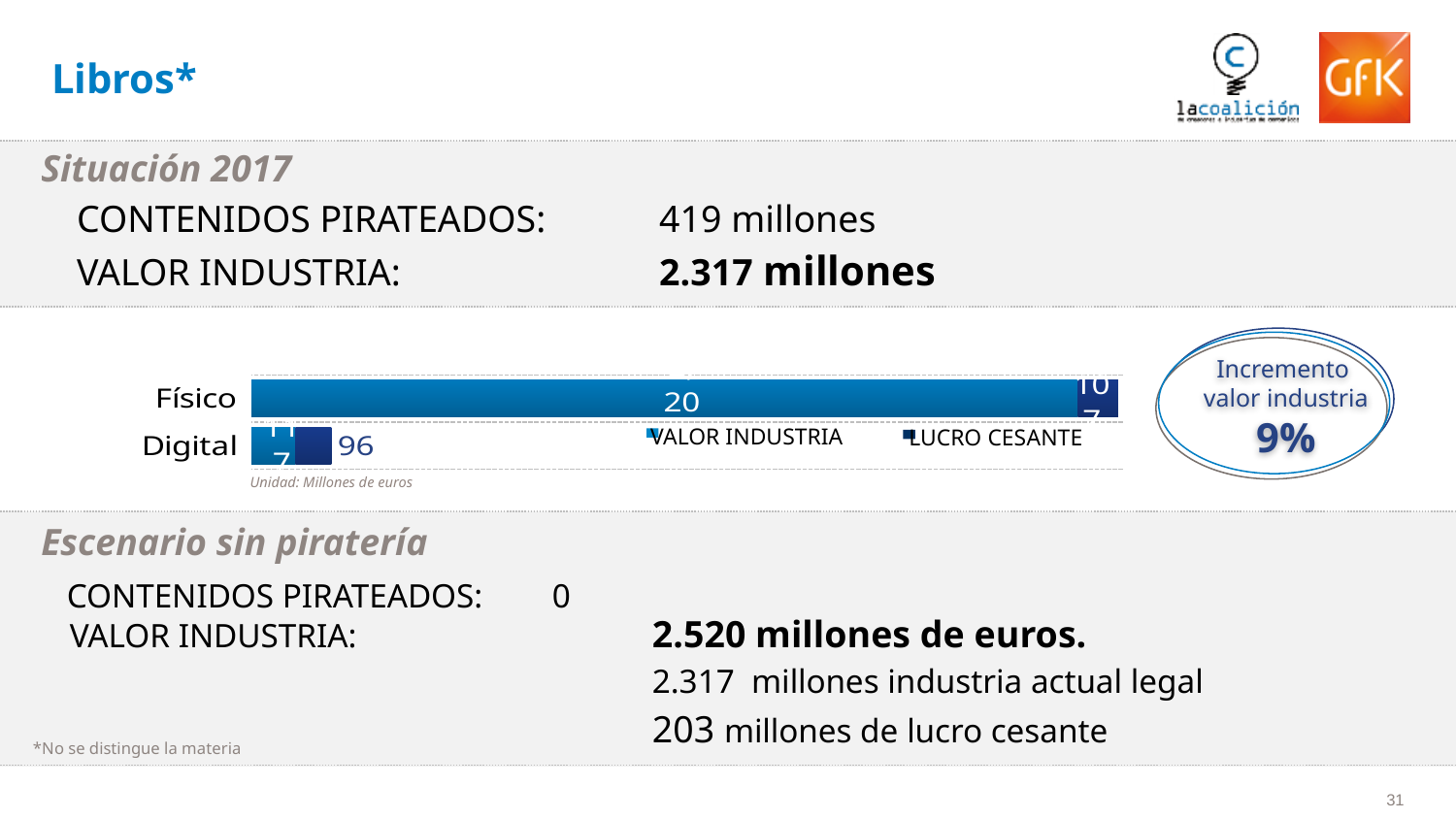
How many series does the legend of the bar chart list? 2 In what unit are the values of the bar chart expressed, according to the note under the chart? Millones de euros Which category has the largest total bar in the chart? Físico What are the two categories shown on the bar chart? Físico and Digital How many categories does the bar chart show? 2 Which category has the smallest total bar in the chart? Digital What kind of chart is shown on the slide? bar chart What are the two series listed in the legend of the bar chart? VALOR INDUSTRIA and LUCRO CESANTE Which category has the longer total bar in the chart, Físico or Digital? Físico What is the LUCRO CESANTE value for Digital in the bar chart? 96